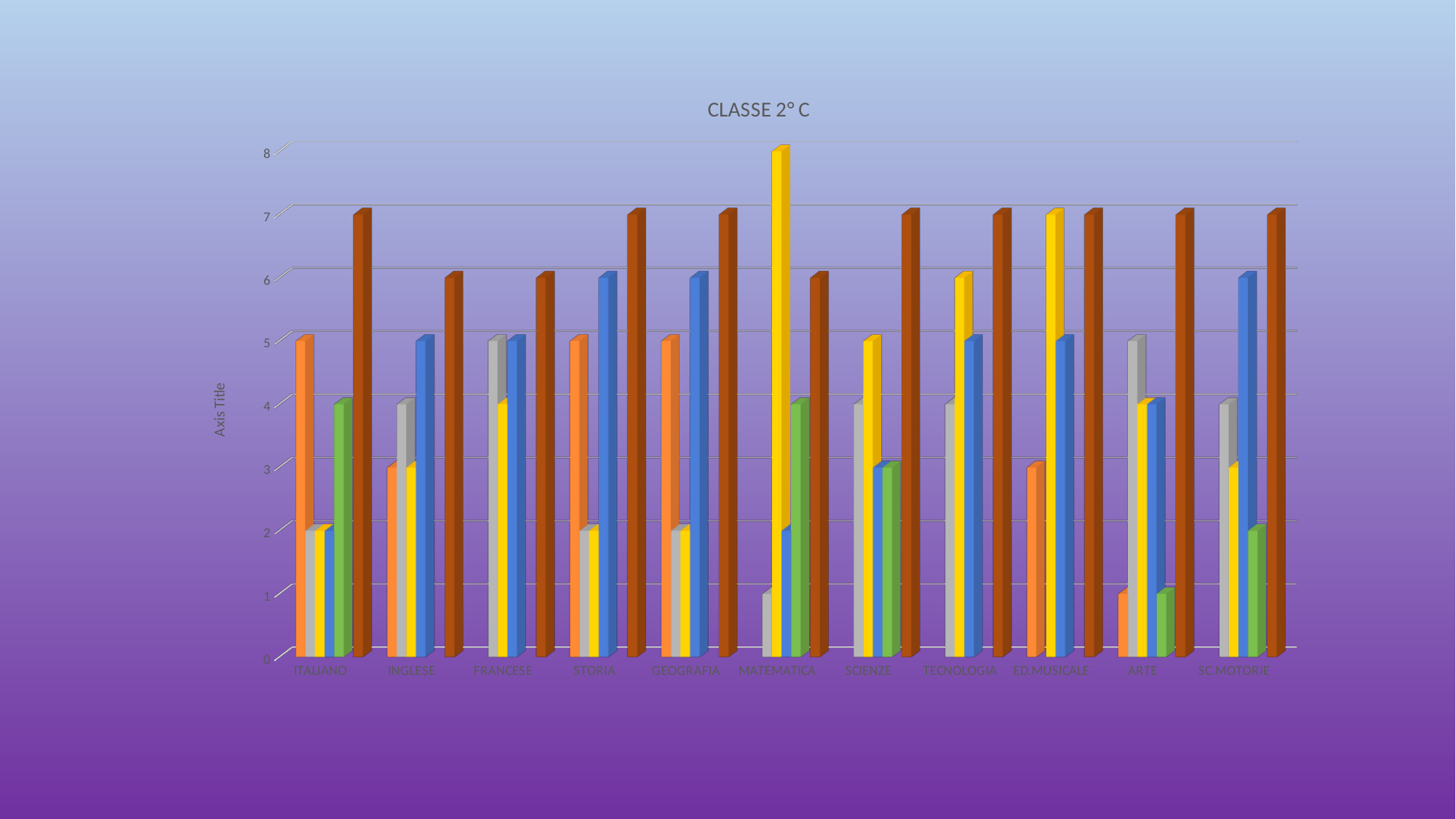
Is the shortest bar for MATEMATICA greater or less than 2? less Is the tallest bar for ITALIANO greater or less than 6? greater What text is shown as the vertical axis title? Axis Title What kind of chart is shown on the slide? bar chart How many categories are shown along the horizontal axis? 11 Is the tallest bar for MATEMATICA greater or less than 7? greater Which category contains the tallest bar in the chart? MATEMATICA What value does the tallest bar in the chart reach? 8 Which category has the taller maximum bar, MATEMATICA or SCIENZE? MATEMATICA What is the title of the chart? CLASSE 2° C